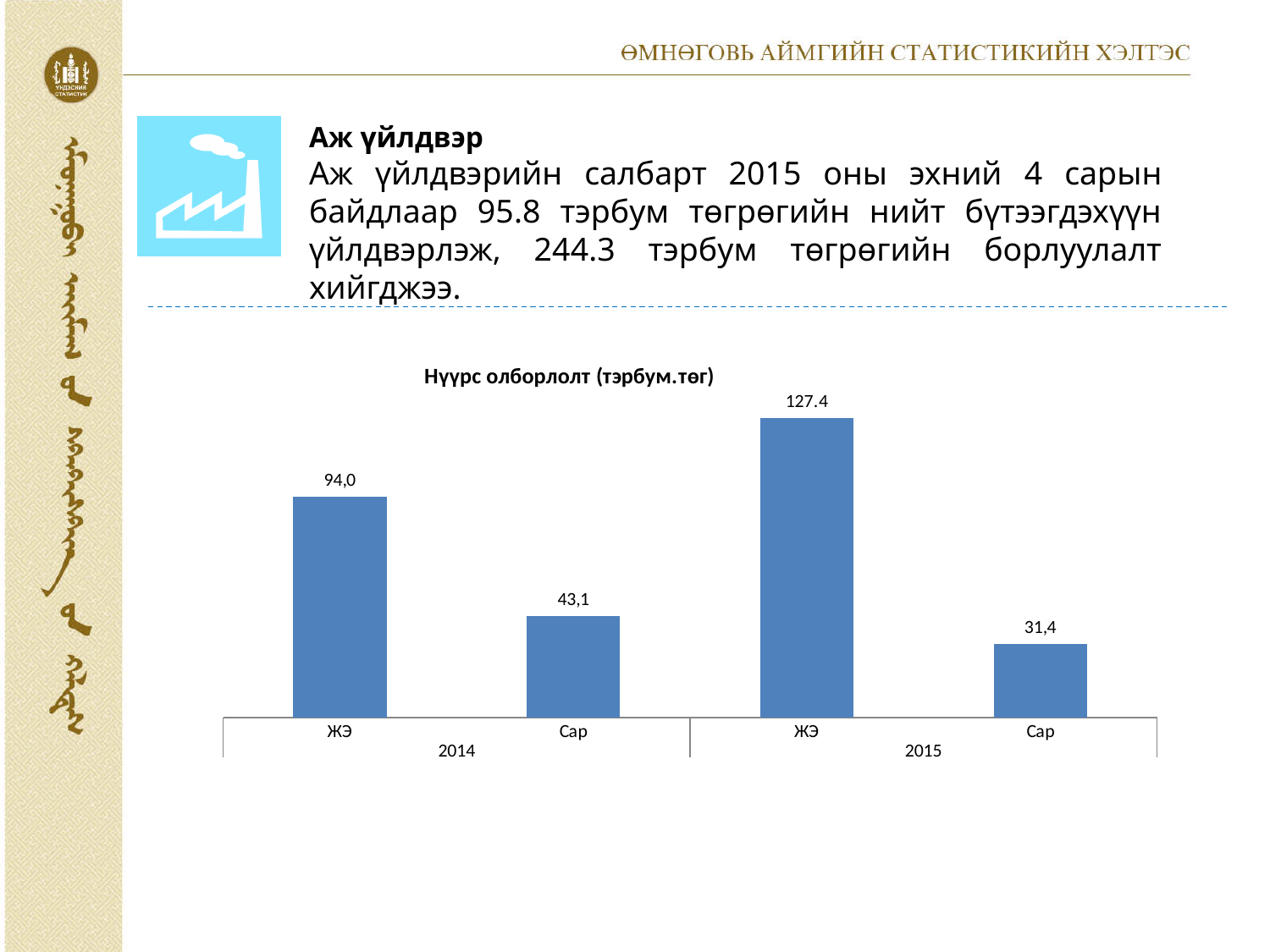
What is the title of the chart? Нүүрс олборлолт (тэрбум.төг) What is the value for Сар in 2015? 31,4 What is the difference between the Сар value in 2014 and the Сар value in 2015? 11,7 Which bar has the lowest value? Сар 2015 What is the value for ЖЭ in 2014? 94,0 What is the value for Сар in 2014? 43,1 How many bars are plotted in the chart? 4 Which is larger, the value for ЖЭ in 2014 or ЖЭ in 2015? ЖЭ 2015 What is the difference between the ЖЭ and Сар values in 2014? 50,9 What type of chart is shown on the slide? bar chart Which bar has the highest value? ЖЭ 2015 What is the value for ЖЭ in 2015? 127.4